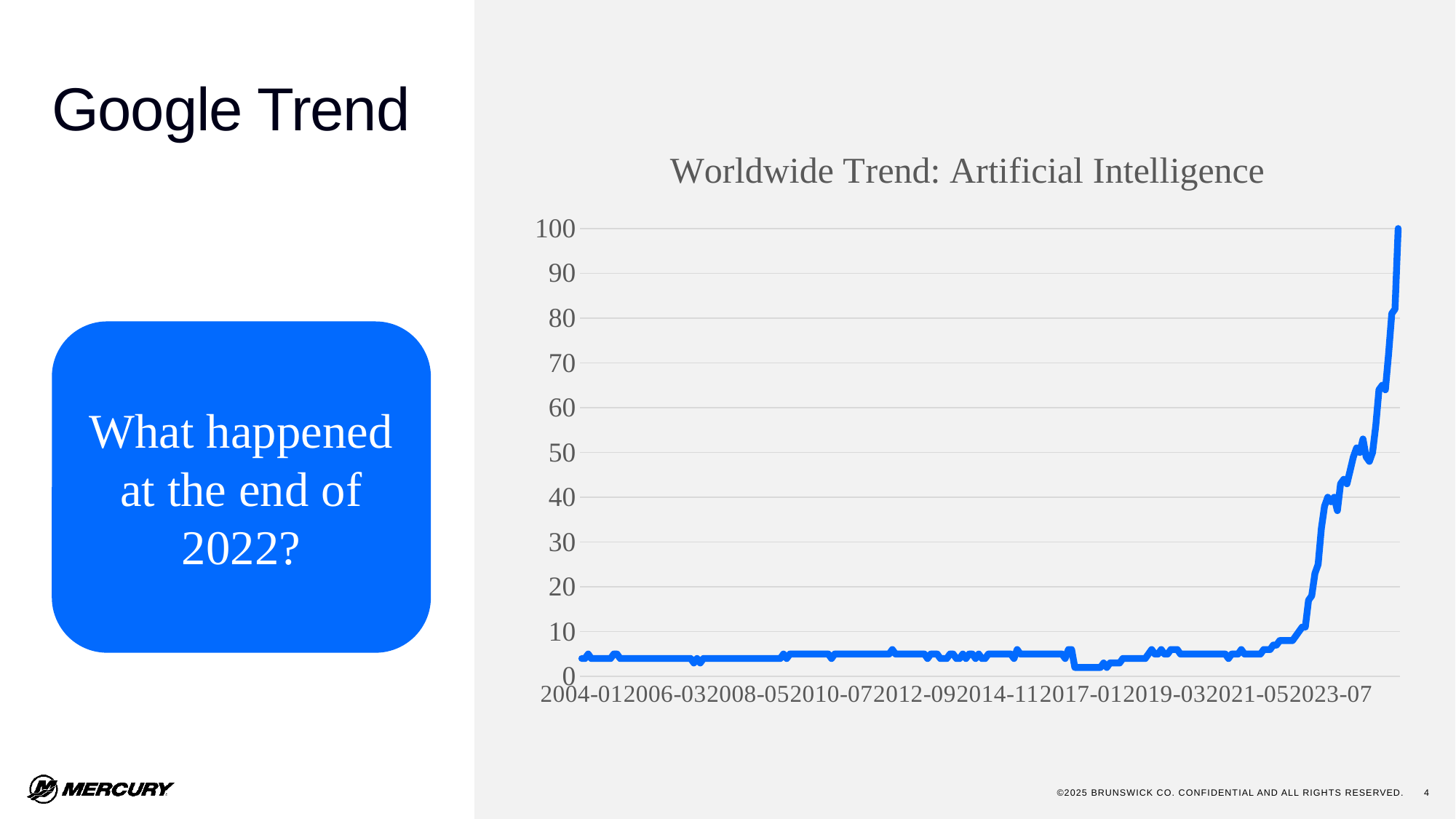
What kind of chart is shown on the slide? line chart Is the value at 2017-01 greater or less than 10? less Is the value at 2004-01 greater or less than 10? less Overall, do the values rise or fall from the start to the end of the x axis? rise Which is larger, the value at 2023-07 or the value at 2004-01? 2023-07 Is the final value at the right end of the line greater or less than 90? greater What is the title of the chart? Worldwide Trend: Artificial Intelligence Is the highest point of the line at the start or the end of the x axis? end What is the maximum value shown on the y axis? 100 How many date labels are shown on the x axis? 10 Near which x-axis label does the line dip to its lowest point? 2017-01